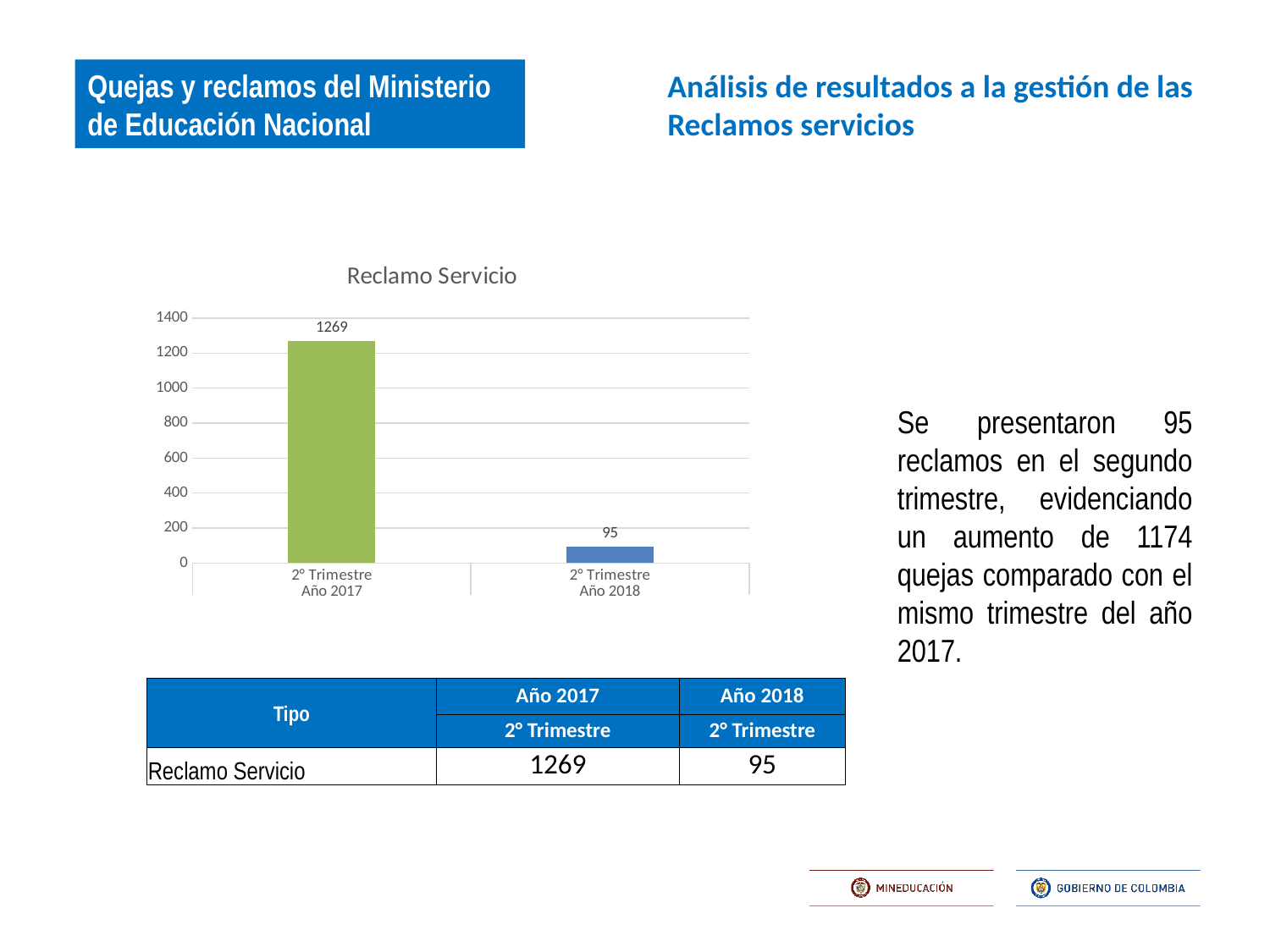
What is the value for 2° Trimestre Año 2017 in the Reclamo Servicio chart? 1269 Is the value for 2° Trimestre Año 2017 greater or less than 1200? greater What is the value for 2° Trimestre Año 2018 in the Reclamo Servicio chart? 95 How many categories are shown on the x axis of the Reclamo Servicio chart? 2 What is the title of the chart on the slide? Reclamo Servicio Which category has the lowest value in the Reclamo Servicio chart? 2° Trimestre Año 2018 What kind of chart is the Reclamo Servicio chart? bar chart Is the value for 2° Trimestre Año 2018 greater or less than 200? less What is the difference between the 2° Trimestre Año 2017 and 2° Trimestre Año 2018 values in the Reclamo Servicio chart? 1174 Which is larger in the Reclamo Servicio chart: the value for 2° Trimestre Año 2017 or 2° Trimestre Año 2018? 2° Trimestre Año 2017 Do the values rise or fall from 2° Trimestre Año 2017 to 2° Trimestre Año 2018 in the Reclamo Servicio chart? fall Which category has the highest value in the Reclamo Servicio chart? 2° Trimestre Año 2017